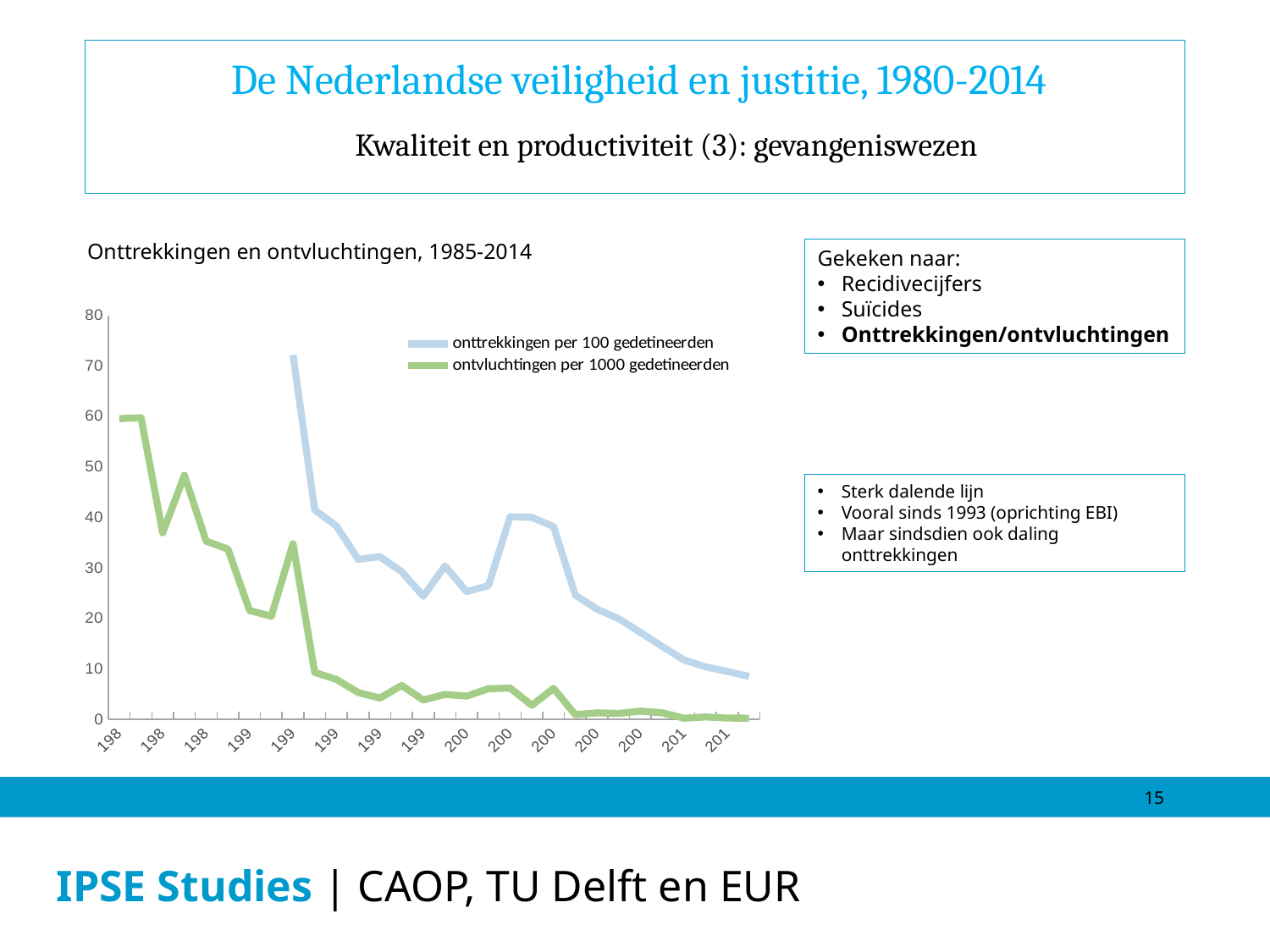
What is the maximum value shown on the y axis of the chart? 80 Does the ontvluchtingen per 1000 gedetineerden series rise or fall overall along the x axis? fall How many series does the legend of the chart list? 2 Does the onttrekkingen per 100 gedetineerden series rise or fall overall from its first point to its last point? fall What is the title of the chart? Onttrekkingen en ontvluchtingen, 1985-2014 Is the last plotted value of the ontvluchtingen per 1000 gedetineerden series greater or less than 10? less Which series is drawn in green in the chart? ontvluchtingen per 1000 gedetineerden At the right end of the chart, which series has the higher value: onttrekkingen per 100 gedetineerden or ontvluchtingen per 1000 gedetineerden? onttrekkingen per 100 gedetineerden Is the first plotted value of the ontvluchtingen per 1000 gedetineerden series greater or less than 50? greater What kind of chart is shown on the slide? line chart Is the highest value of the onttrekkingen per 100 gedetineerden series greater or less than 70? greater